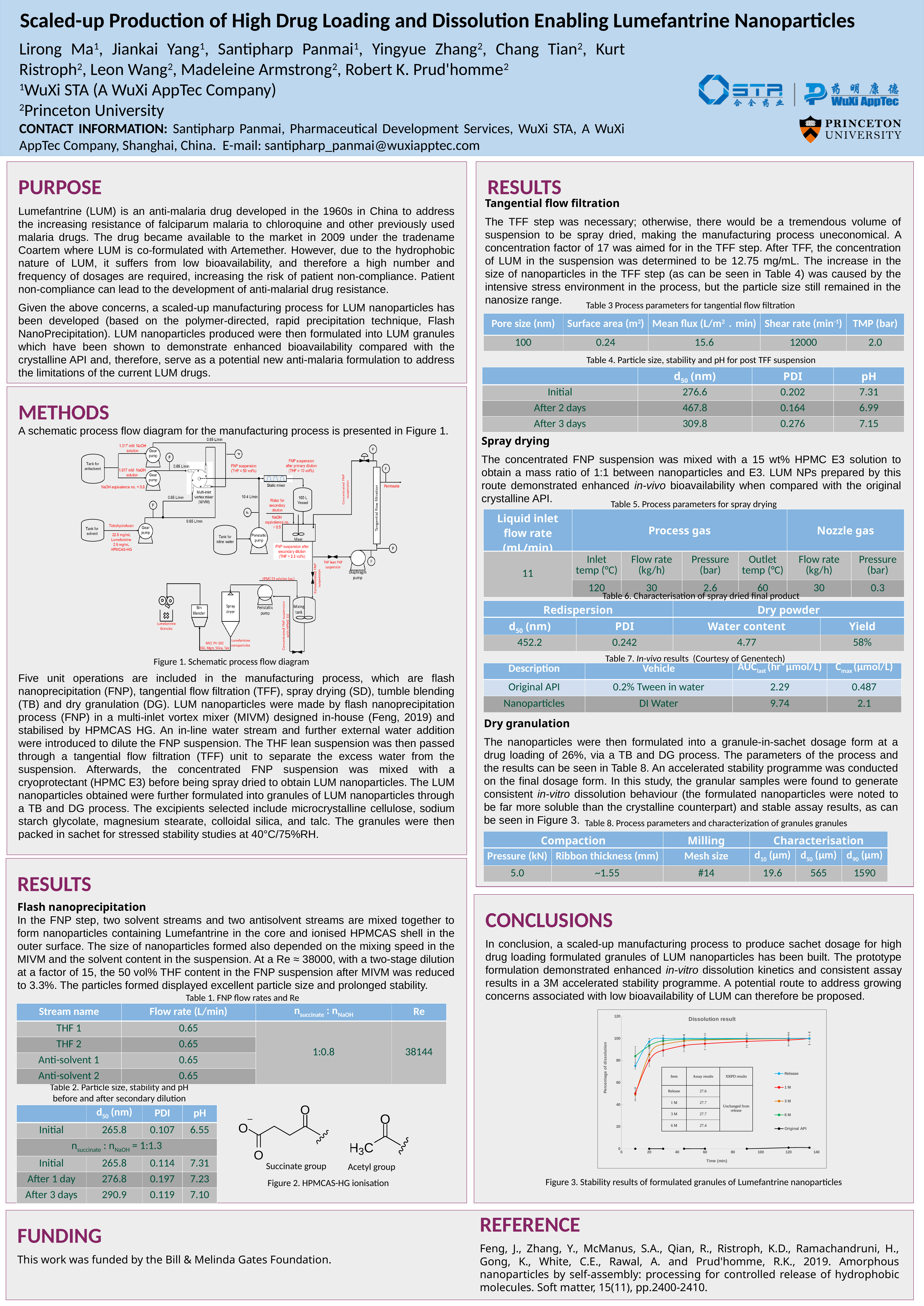
In the "Dissolution result" chart, which series has the lowest values across the time axis? Original API In the table inside the "Dissolution result" chart, what is the assay result listed for Release? 27.6 In the "Dissolution result" chart, does the Release series rise or fall as time increases along the x axis? rises How many series does the legend of the "Dissolution result" chart list? 5 What is the title of the chart in Figure 3? Dissolution result What kind of chart is the "Dissolution result" chart in Figure 3? line chart In the "Dissolution result" chart, is the value for Release at 120 min greater or less than 80? greater In the table inside the "Dissolution result" chart, what is the assay result listed for 6 M? 27.4 In the "Dissolution result" chart, which is larger at 120 min: Release or Original API? Release In the "Dissolution result" chart, is the value for Original API at 120 min greater or less than 20? less What is the y-axis label of the "Dissolution result" chart? Percentage of dissolution